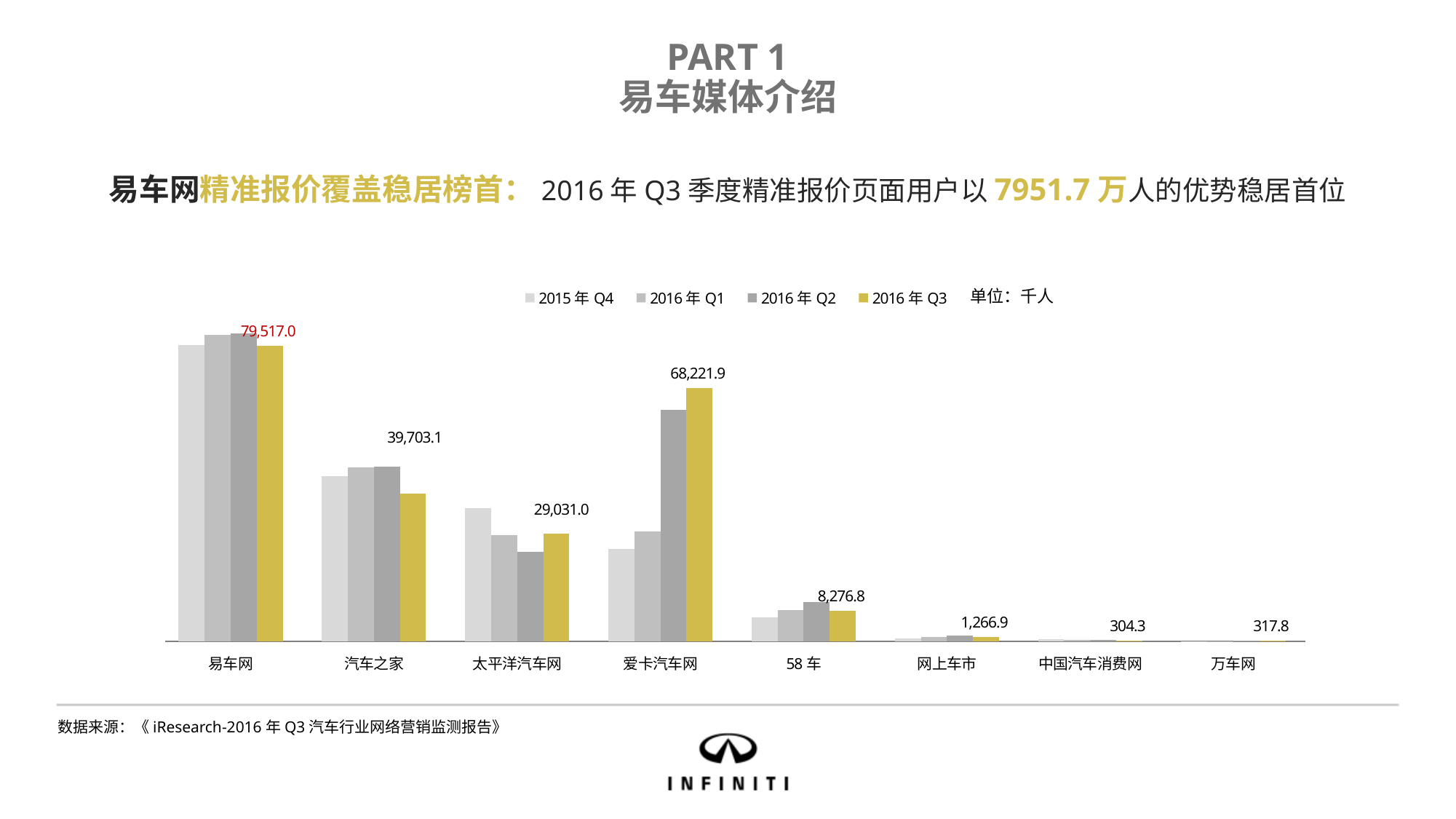
What unit is stated next to the legend? 千人 Which category has the highest 2016 年 Q3 value? 易车网 How many series does the legend list? 4 What is the 2016 年 Q3 value for 爱卡汽车网? 68,221.9 Which category has the lowest 2016 年 Q3 value? 中国汽车消费网 What is the 2016 年 Q3 value for 汽车之家? 39,703.1 What is the difference between the 2016 年 Q3 values for 易车网 and 爱卡汽车网? 11,295.1 Which has the larger 2016 年 Q3 value, 汽车之家 or 太平洋汽车网? 汽车之家 What is the 2016 年 Q3 value for 网上车市? 1,266.9 How many categories are shown on the x axis? 8 What is the 2016 年 Q3 value for 易车网? 79,517.0 What kind of chart is shown on the slide? bar chart